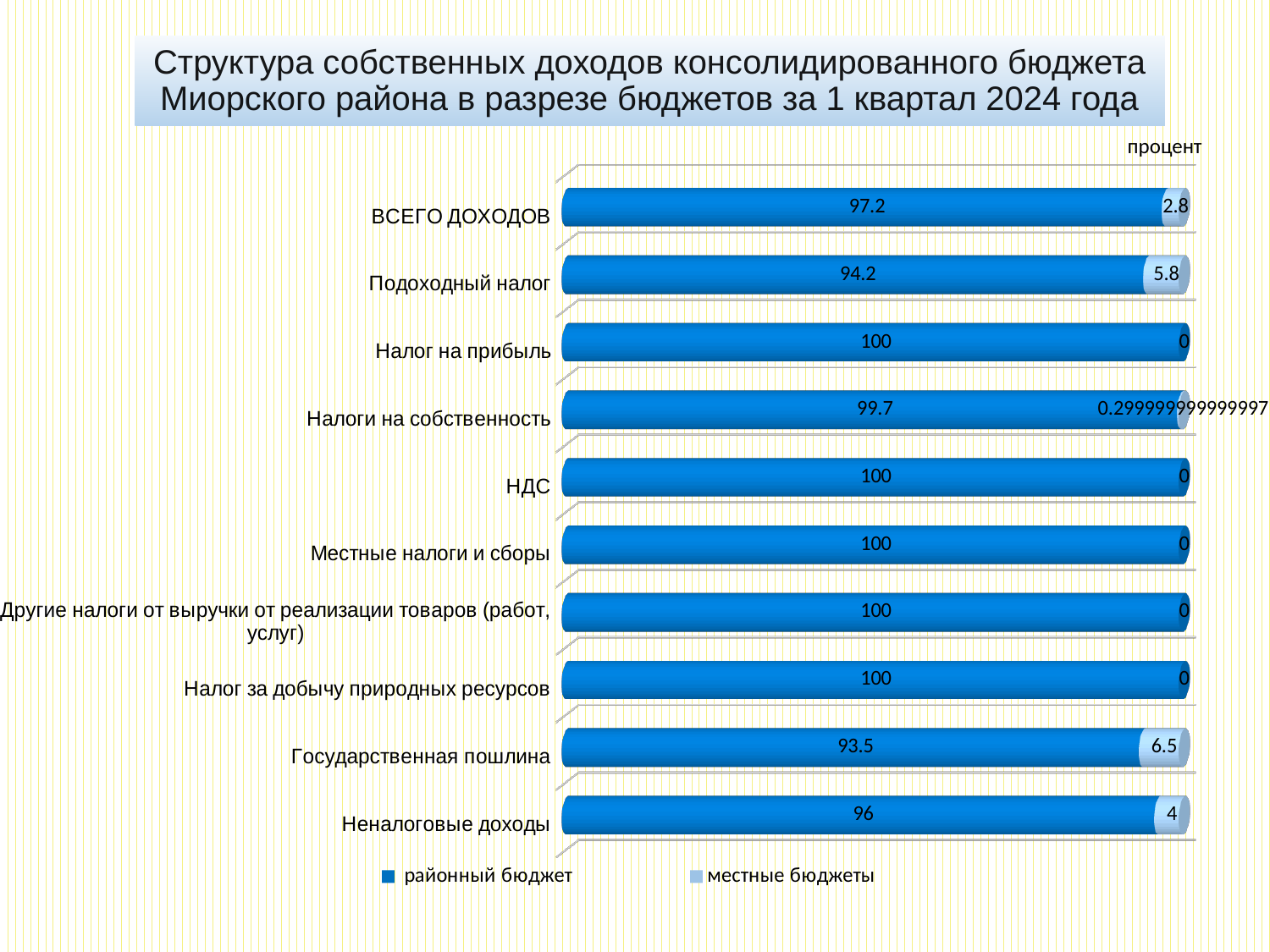
Which category has the lowest value for районный бюджет? Государственная пошлина What is the difference between the районный бюджет values for Подоходный налог and Государственная пошлина? 0.7 Which category has the highest value for местные бюджеты? Государственная пошлина What kind of chart is shown on the slide? bar chart What is the value of районный бюджет for Налоги на собственность? 99.7 What is the value of районный бюджет for ВСЕГО ДОХОДОВ? 97.2 What is the value of районный бюджет for Неналоговые доходы? 96 What is the value of местные бюджеты for Подоходный налог? 5.8 How many categories are plotted on the chart? 10 How many series does the legend list? 2 Which is larger: the местные бюджеты value for Неналоговые доходы or for ВСЕГО ДОХОДОВ? Неналоговые доходы What is the value of местные бюджеты for Государственная пошлина? 6.5